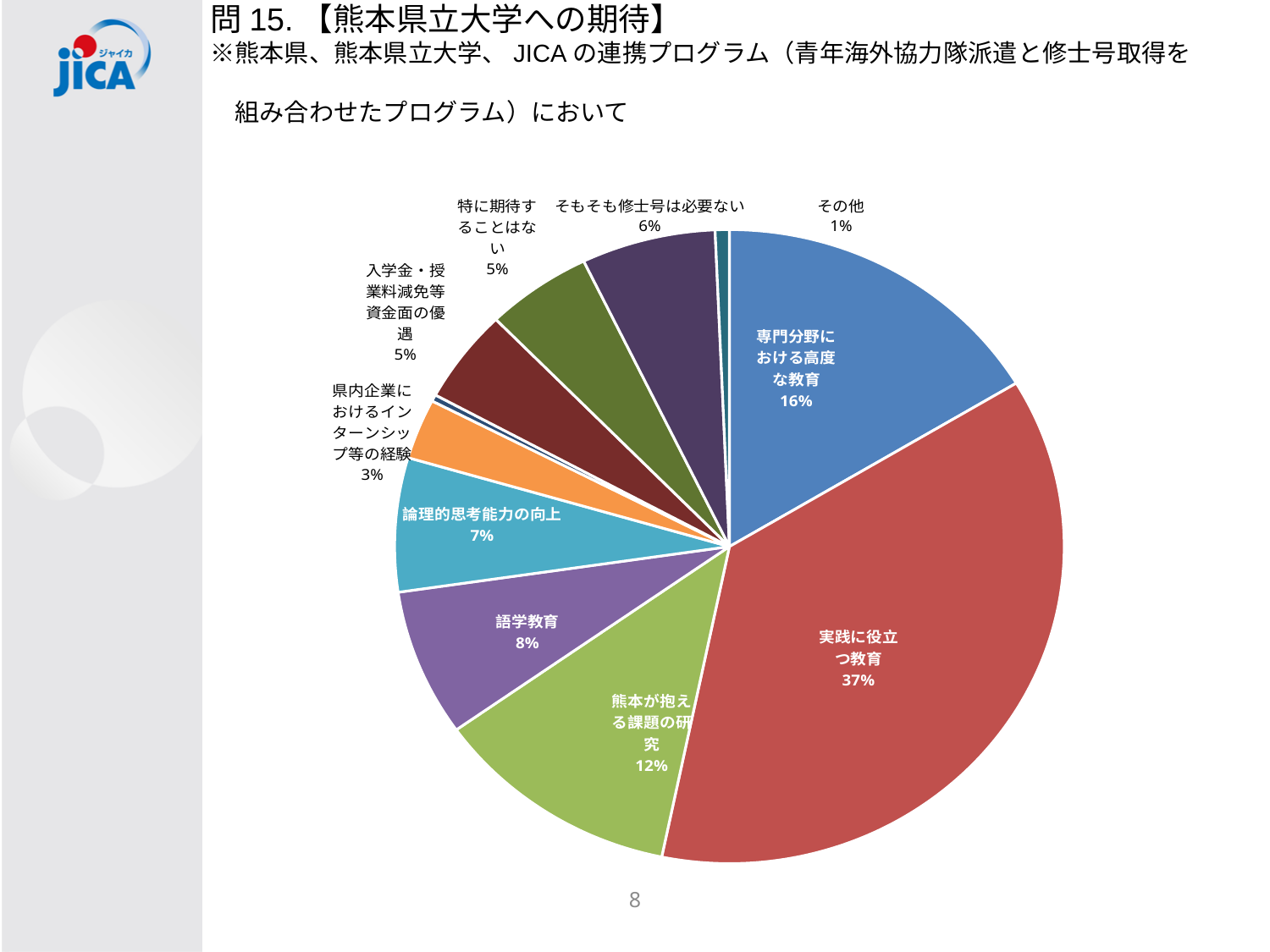
What percentage of the pie chart is 実践に役立つ教育? 37% What percentage is shown for 熊本が抱える課題の研究? 12% Which is larger, 論理的思考能力の向上 or 語学教育? 語学教育 What colour is the slice for 実践に役立つ教育? Red What share does 専門分野における高度な教育 have in the pie chart? 16% What percentage is shown for そもそも修士号は必要ない? 6% What is the combined share of 実践に役立つ教育 and 熊本が抱える課題の研究? 49% What is the difference in percentage points between 実践に役立つ教育 and 専門分野における高度な教育? 21 What type of chart is shown on the slide? Pie chart What percentage is shown for 語学教育? 8% Which category has the largest share of the pie chart? 実践に役立つ教育 Which labeled category has the smallest share of the pie chart? その他